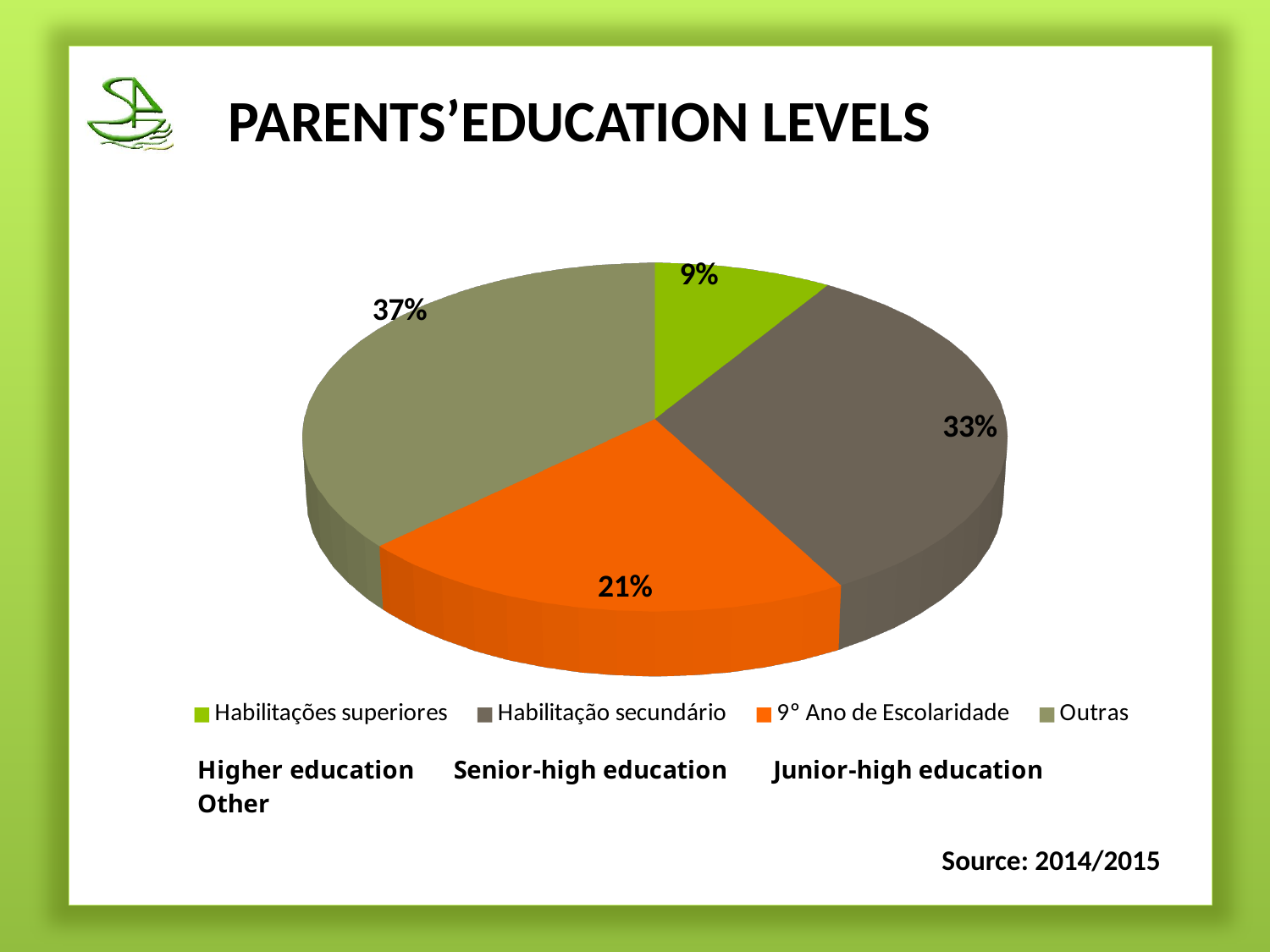
Which category has the largest share of the pie? Outras What percentage is shown for 9° Ano de Escolaridade? 21% What percentage is shown for Habilitação secundário? 33% What is the title of the slide containing the chart? PARENTS'EDUCATION LEVELS What percentage is shown for Habilitações superiores? 9% Which is larger, the share for 9° Ano de Escolaridade or the share for Habilitação secundário? Habilitação secundário What percentage is shown for Outras? 37% Which category has the smallest share of the pie? Habilitações superiores What kind of chart is shown on the slide? Pie chart What colour is the slice for 9° Ano de Escolaridade? Orange How many categories does the pie chart have? 4 What is the difference in percentage points between Outras and Habilitação secundário? 4